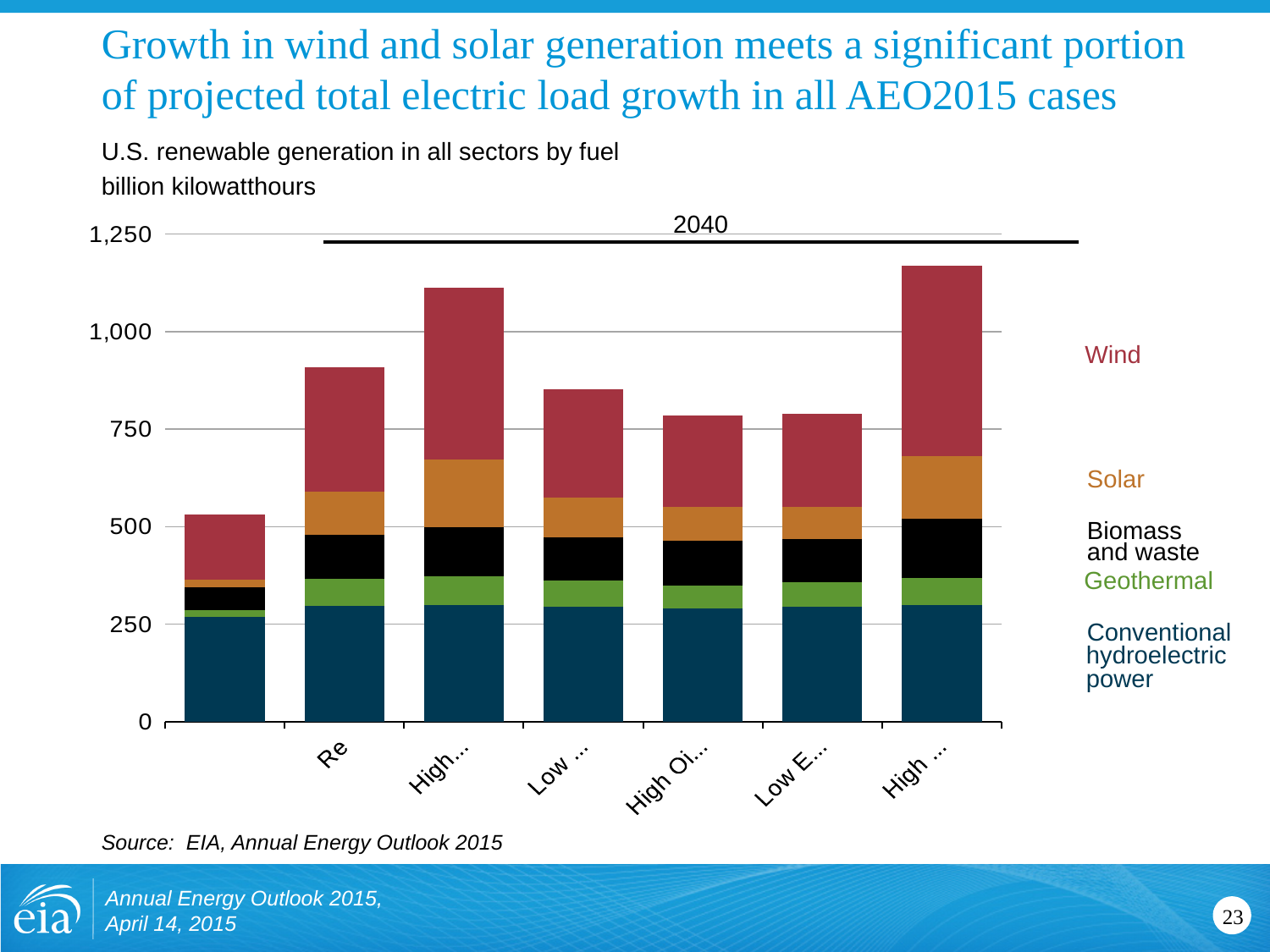
Is the total of the rightmost bar greater or less than 1,000 billion kilowatthours? greater What kind of chart is shown on the slide? Stacked bar chart How many bars (cases) are plotted in the chart? 7 What unit is the y axis measured in? billion kilowatthours Which series is shown at the top of each stacked bar? Wind Which bar has the lowest total renewable generation? The leftmost (first) bar Which has a larger total, the first bar or the second bar from the left? The second bar Is the total of the leftmost bar greater or less than 500 billion kilowatthours? greater Which bar has the highest total renewable generation? The rightmost (seventh) bar Is the total of the fifth bar from the left greater or less than 1,000 billion kilowatthours? less How many fuel series does the legend list? 5